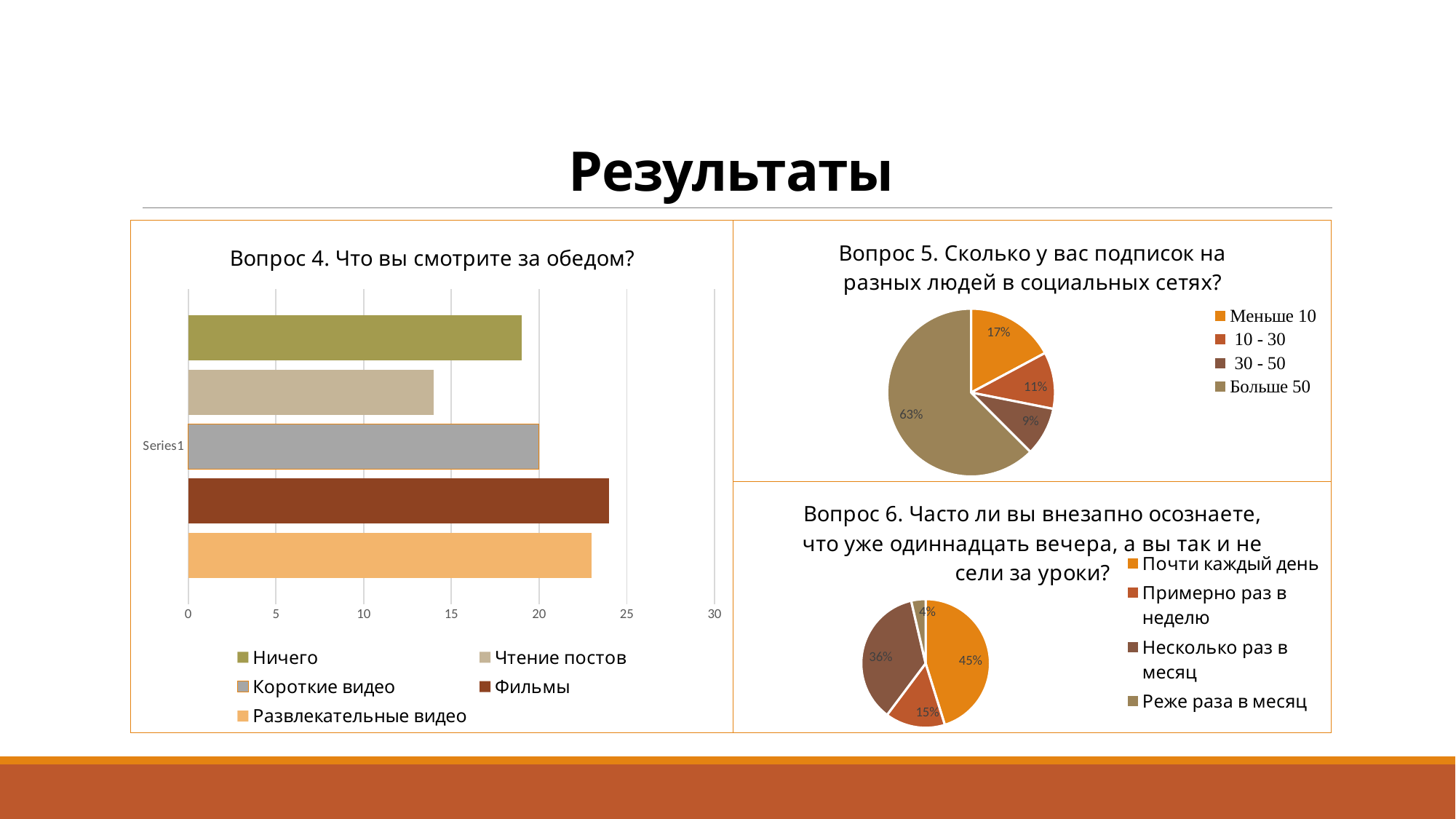
On the chart 'Вопрос 4. Что вы смотрите за обедом?', what kind of chart is it? bar chart On the pie chart 'Вопрос 5', what is the difference between the shares for Меньше 10 and 10 - 30? 6% On the chart 'Вопрос 4. Что вы смотрите за обедом?', how many categories does the legend list? 5 On the chart 'Вопрос 4. Что вы смотрите за обедом?', which is larger, Ничего or Чтение постов? Ничего On the pie chart 'Вопрос 6', what share is labelled for Несколько раз в месяц? 36% On the pie chart 'Вопрос 6', which category has the largest share? Почти каждый день On the pie chart 'Вопрос 5', what share is labelled for 30 - 50? 9% On the chart 'Вопрос 4. Что вы смотрите за обедом?', is the value for Чтение постов greater or less than 15? less On the pie chart 'Вопрос 5', what share is labelled for Больше 50? 63% On the pie chart 'Вопрос 6', which category has the smallest share? Реже раза в месяц On the chart 'Вопрос 4. Что вы смотрите за обедом?', which category has the lowest value? Чтение постов On the chart 'Вопрос 4. Что вы смотрите за обедом?', is the value for Фильмы greater or less than 20? greater